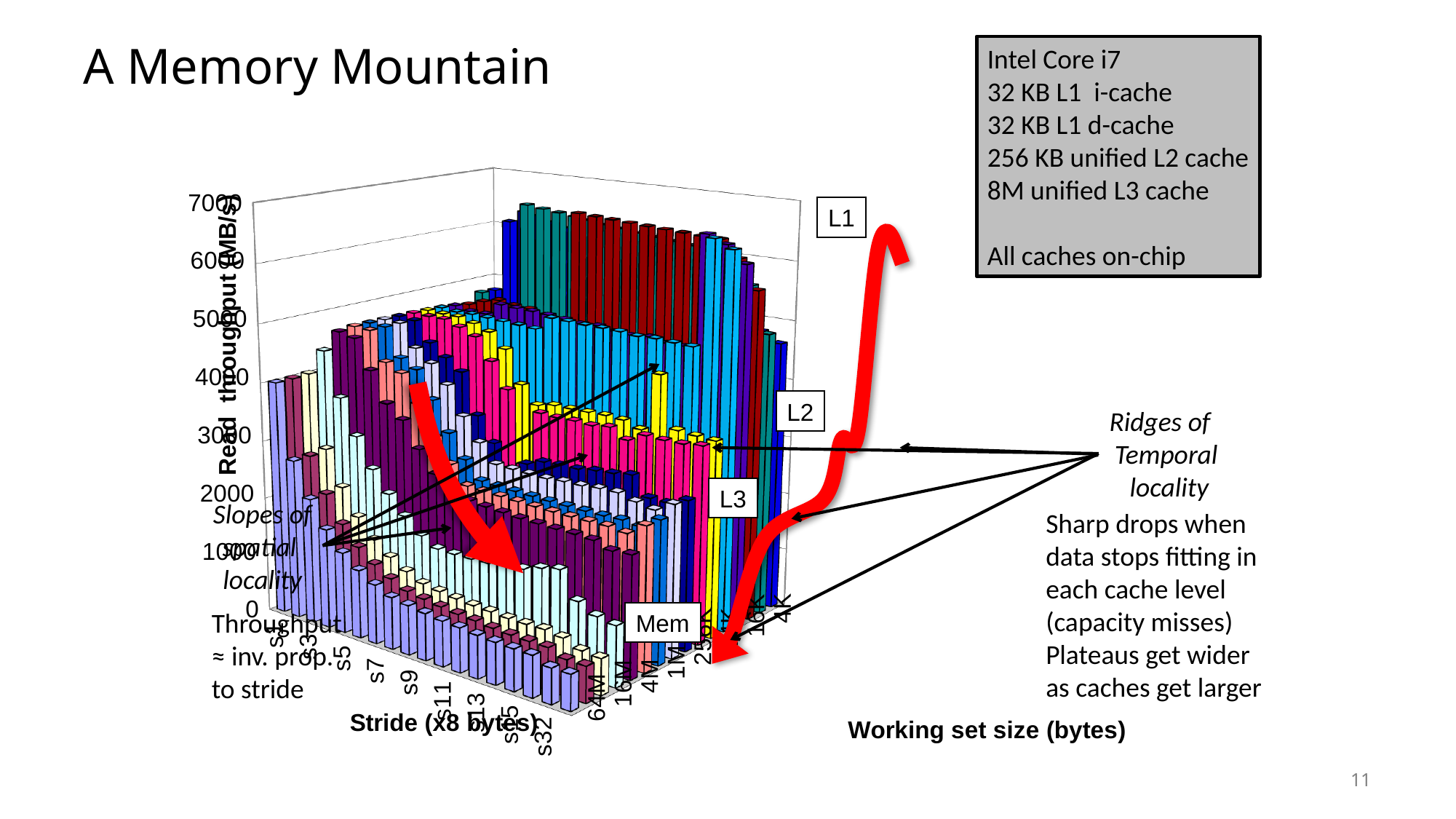
What is the lowest tick value shown on the vertical axis of the chart? 0 Which label marks the lowest plateau of the chart, at the largest working set sizes? Mem What kind of chart is shown on the slide? 3D bar chart What is the largest stride labelled on the chart's stride axis? s32 Which cache level label is placed next to the highest ridge of the chart? L1 As the working set size grows from 4K toward 64M, does read throughput rise or fall? fall Is the tallest bar in the chart greater or less than 5000 MB/s? greater What is the title of the slide containing the chart? A Memory Mountain What quantity is plotted on the vertical axis of the chart? Read throughput (MB/s) Along the stride axis, does read throughput rise or fall as the stride increases? fall What is the highest tick value shown on the vertical axis of the chart? 7000 What is the largest working set size labelled on the chart's depth axis? 64M